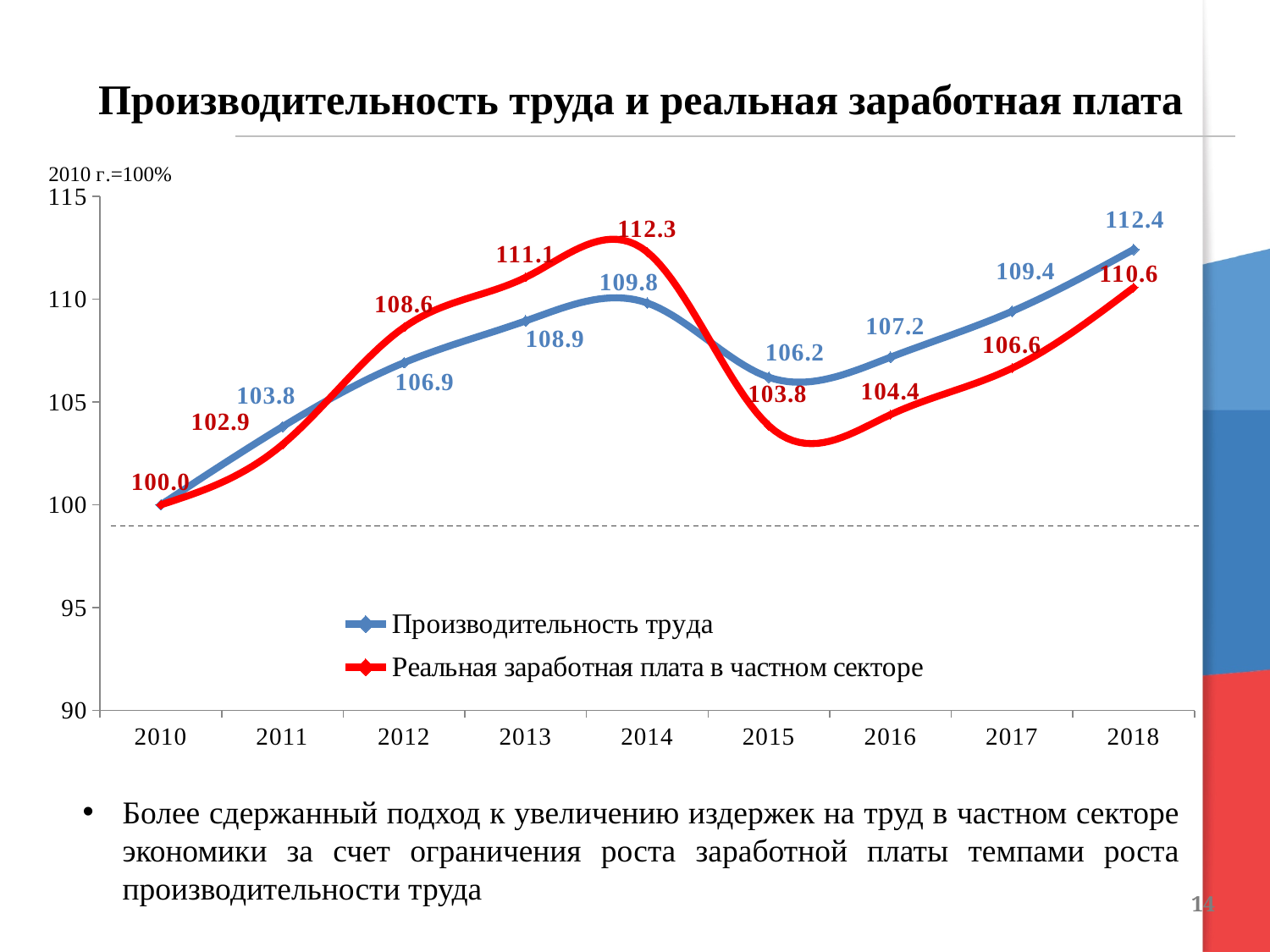
Is the value of Производительность труда in 2016 greater or less than 105? greater In 2013, which series has the higher value: Производительность труда or Реальная заработная плата в частном секторе? Реальная заработная плата в частном секторе What is the value of Производительность труда in 2018? 112.4 What is the difference between Производительность труда and Реальная заработная плата в частном секторе in 2015? 2.4 How many series does the legend list? 2 In which year does Реальная заработная плата в частном секторе reach its highest value? 2014 What is the value of Реальная заработная плата в частном секторе in 2013? 111.1 What is the value of Производительность труда in 2014? 109.8 Excluding the 2010 base year, in which year is Реальная заработная плата в частном секторе lowest? 2011 Does Производительность труда rise or fall from 2015 to 2018? rise What kind of chart is shown on the slide? line chart How many years are shown on the x axis? 9